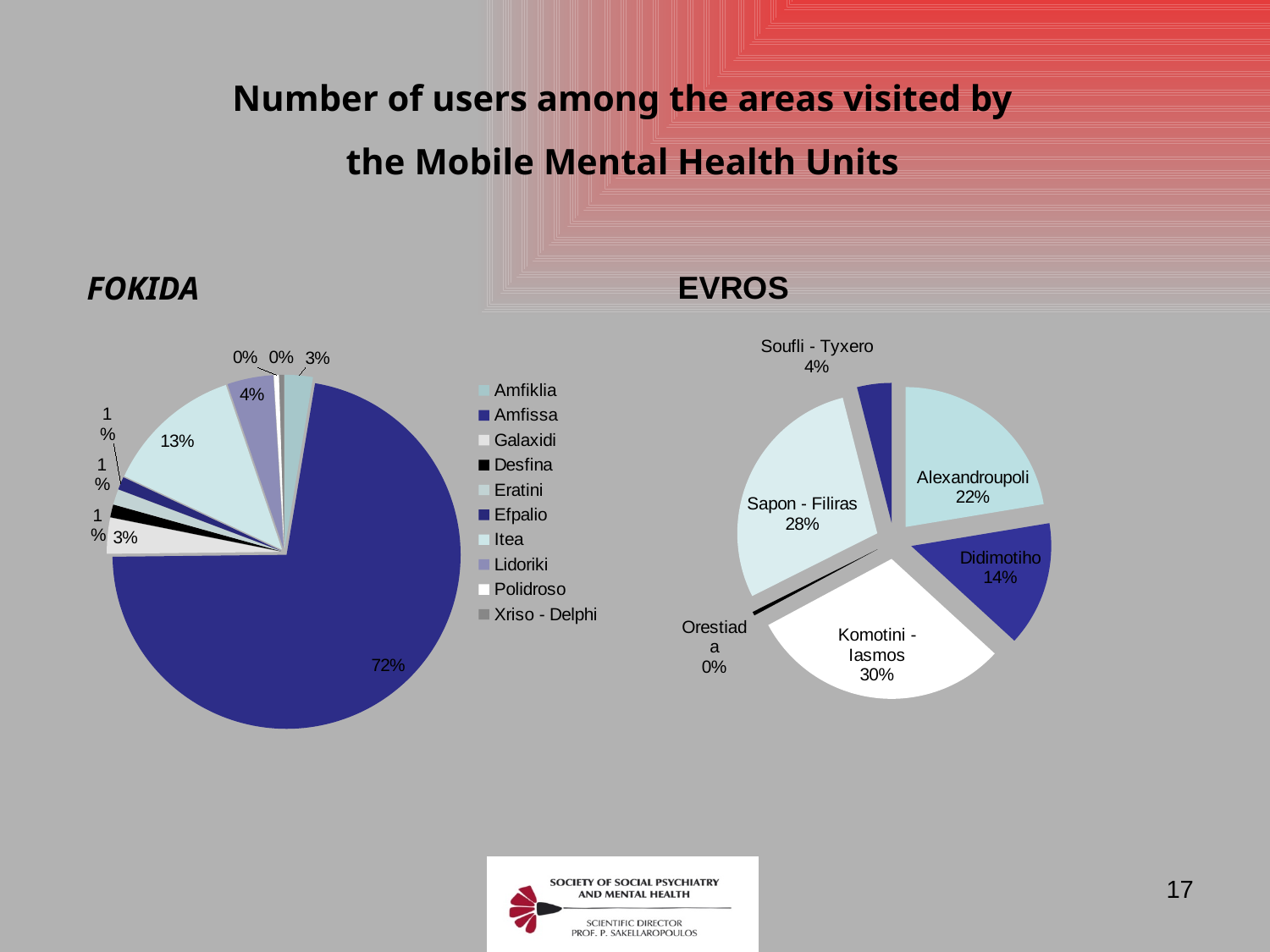
In the EVROS chart, what percentage is shown for Soufli - Tyxero? 4% In the EVROS chart, which area has the smallest share of users? Orestiada What type of chart is the FOKIDA chart? Pie chart In the FOKIDA chart, what percentage does the largest slice represent? 72% In the EVROS chart, what share of users is shown for Komotini - Iasmos? 30% In the FOKIDA chart, which area accounts for the largest share of users? Amfissa In the EVROS chart, what is the difference in percentage points between Sapon - Filiras and Didimotiho? 14 percentage points How many areas does the legend of the FOKIDA chart list? 10 How many areas are shown in the EVROS chart? 6 In the EVROS chart, which has the larger share: Sapon - Filiras or Alexandroupoli? Sapon - Filiras In the EVROS chart, what percentage is shown for Alexandroupoli? 22% In the EVROS chart, which area has the largest share of users? Komotini - Iasmos